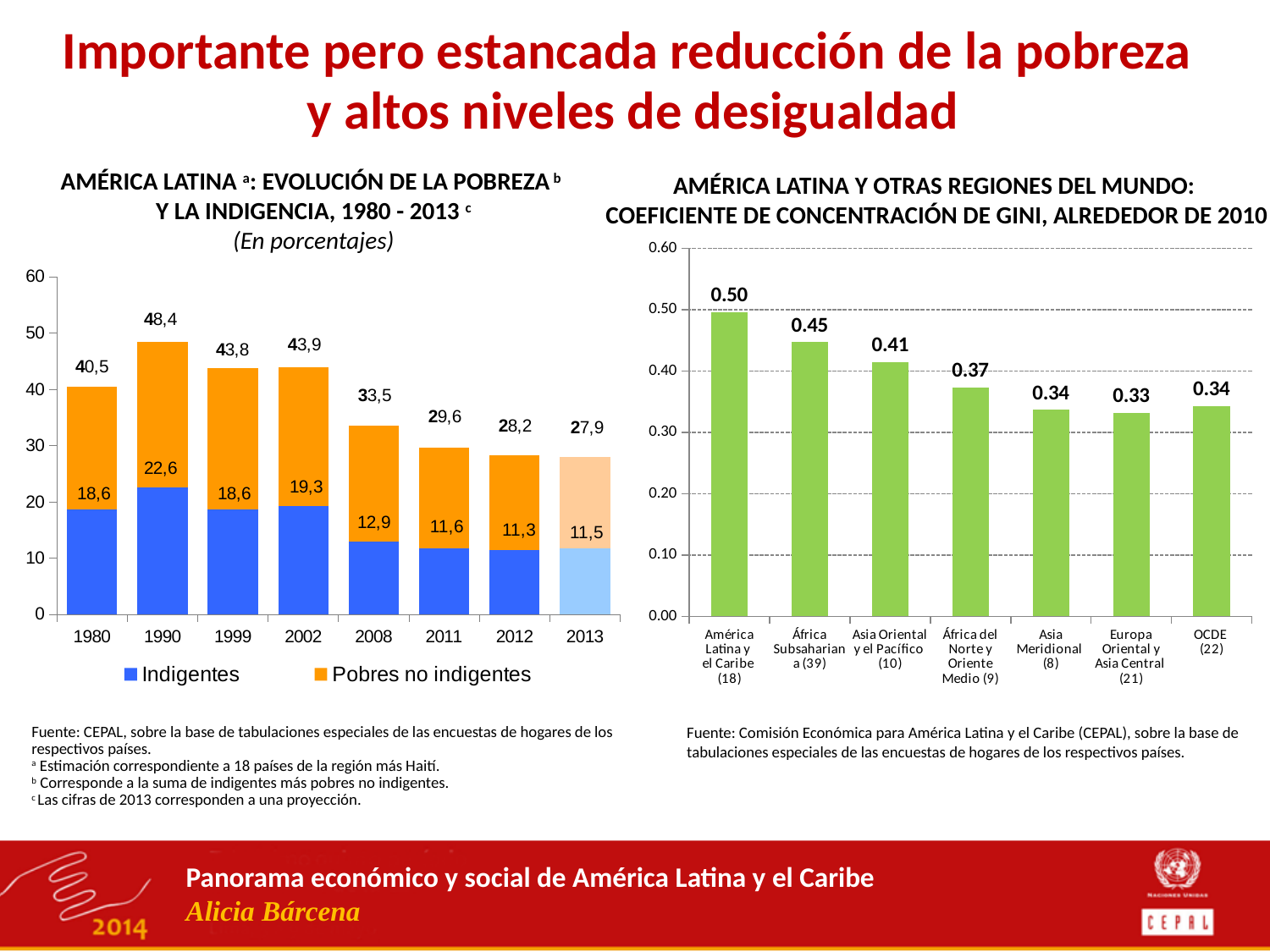
In the left chart (Evolución de la pobreza y la indigencia), which year has the highest total poverty value? 1990 What kind of chart is the right chart (Coeficiente de concentración de Gini)? bar chart In the right chart (Coeficiente de concentración de Gini), what is the difference between África Subsahariana (39) and África del Norte y Oriente Medio (9)? 0.08 In the left chart (Evolución de la pobreza y la indigencia), what is the Indigentes value for 2008? 12,9 In the right chart (Coeficiente de concentración de Gini), what is the value for América Latina y el Caribe (18)? 0.50 In the left chart (Evolución de la pobreza y la indigencia), what is the difference between the total for 1980 and the Indigentes value for 1980? 21,9 In the left chart (Evolución de la pobreza y la indigencia), what is the total poverty value shown for 1990? 48,4 In the left chart (Evolución de la pobreza y la indigencia), which year has the lowest Indigentes value? 2012 In the right chart (Coeficiente de concentración de Gini), which region has the lowest Gini coefficient? Europa Oriental y Asia Central (21) In the left chart (Evolución de la pobreza y la indigencia), how many series does the legend list? 2 In the left chart (Evolución de la pobreza y la indigencia), do the total poverty values rise or fall from 2002 to 2013? fall In the left chart (Evolución de la pobreza y la indigencia), how many years are shown on the x axis? 8